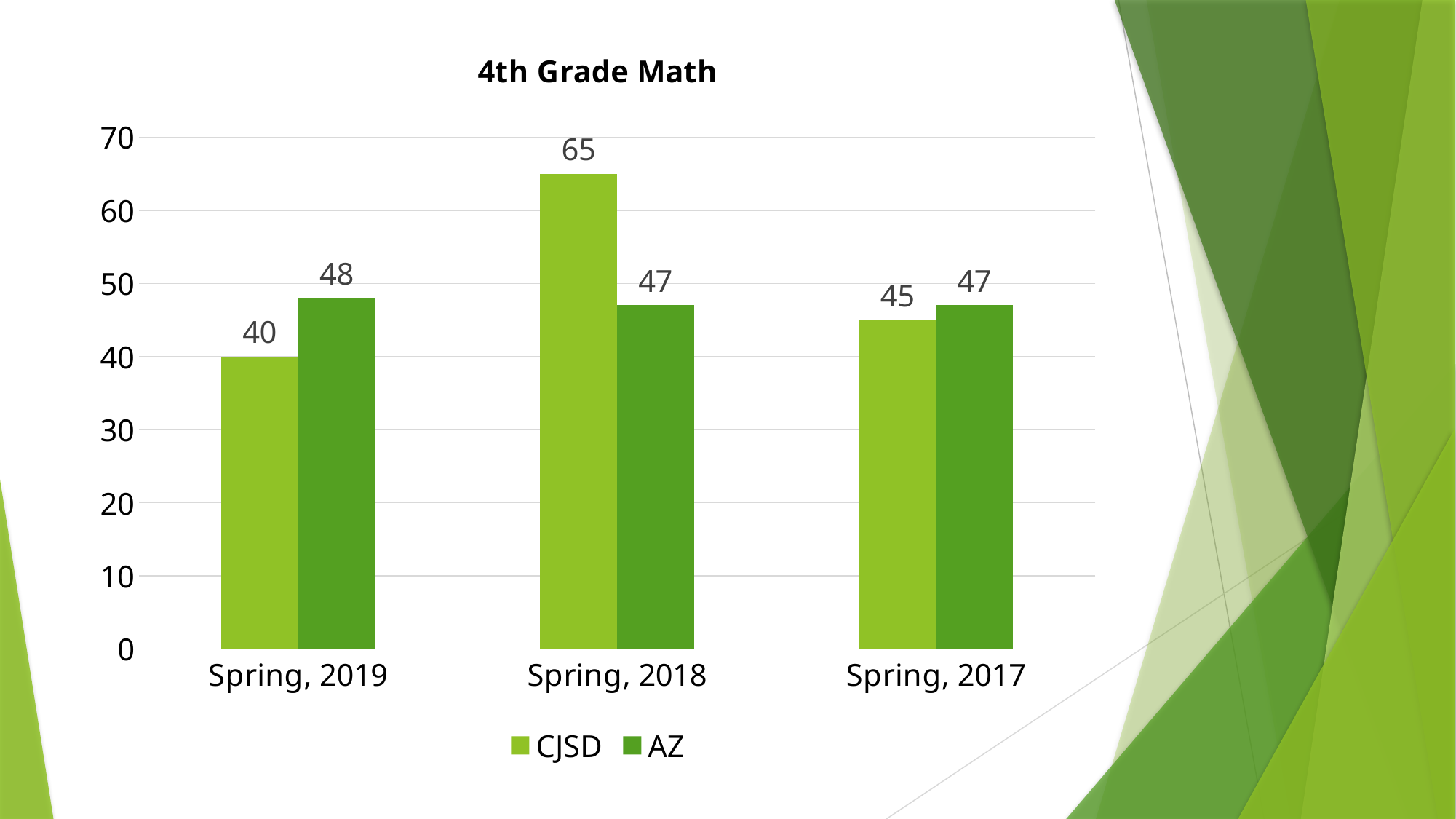
What is the title of the chart? 4th Grade Math What is the CJSD value for Spring, 2017? 45 What kind of chart is shown? Bar chart How many series does the legend list? 2 What is the difference between the CJSD and AZ values for Spring, 2018? 18 Which period has the highest CJSD value? Spring, 2018 Which is larger for Spring, 2017, CJSD or AZ? AZ What is the AZ value for Spring, 2019? 48 Which period has the lowest CJSD value? Spring, 2019 What is the CJSD value for Spring, 2018? 65 How many periods are shown on the x axis? 3 What is the difference between the AZ and CJSD values for Spring, 2019? 8